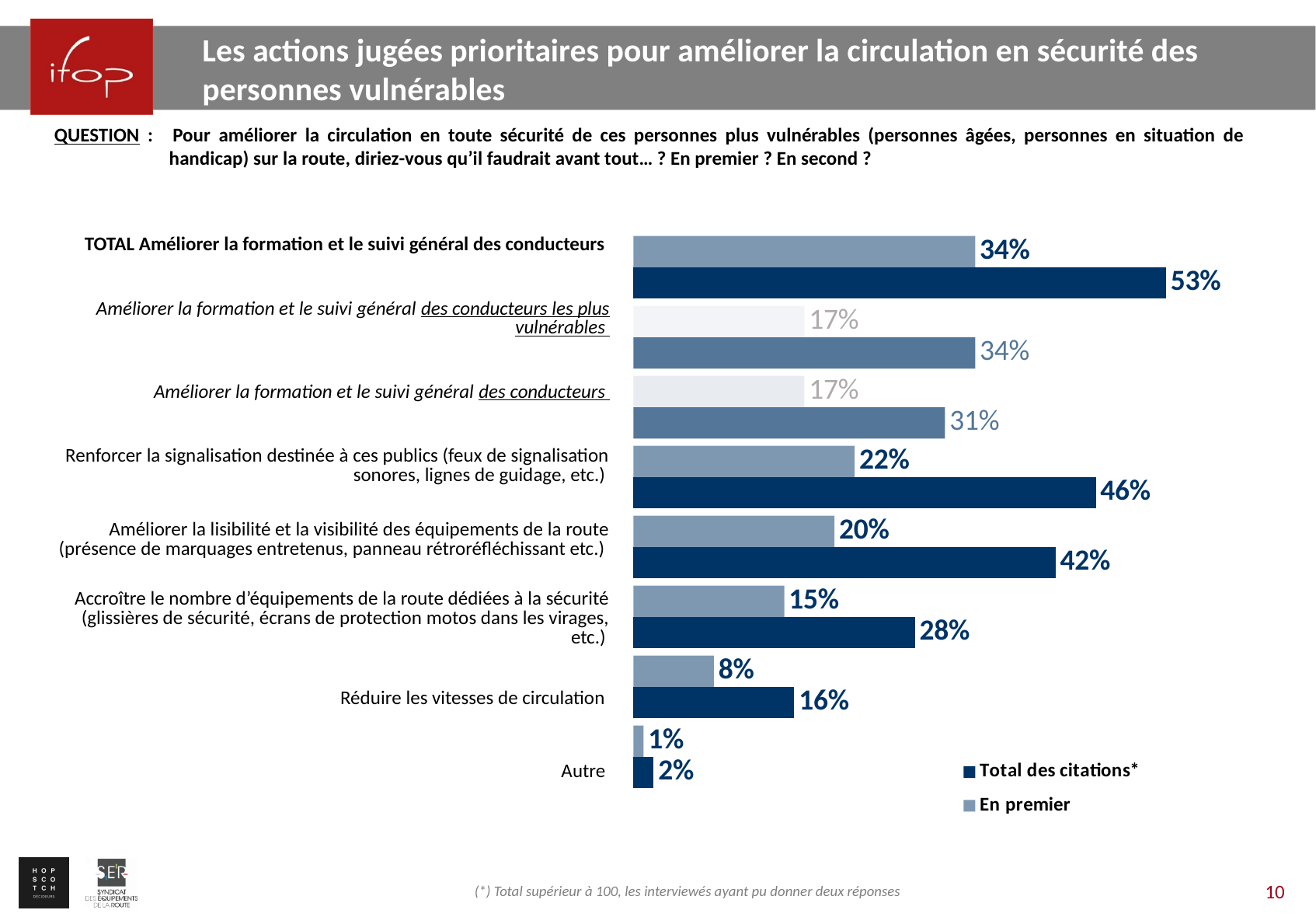
How many categories are shown on the chart? 8 Which category has the lowest 'En premier' value? Autre What is the 'En premier' value for 'TOTAL Améliorer la formation et le suivi général des conducteurs'? 34% Which is larger: the 'Total des citations' value for 'Renforcer la signalisation destinée à ces publics' or for 'Améliorer la lisibilité et la visibilité des équipements de la route'? Renforcer la signalisation destinée à ces publics How many series does the legend list? 2 What are the two legend entries of the chart? Total des citations* and En premier What is the difference between the 'Total des citations' and 'En premier' values for 'Accroître le nombre d'équipements de la route dédiées à la sécurité'? 13% What is the 'Total des citations' value for 'Renforcer la signalisation destinée à ces publics'? 46% What is the 'Total des citations' value for 'Réduire les vitesses de circulation'? 16% What kind of chart is shown on the slide? bar chart What is the 'En premier' value for 'Améliorer la lisibilité et la visibilité des équipements de la route'? 20% Which category has the highest 'Total des citations' value? TOTAL Améliorer la formation et le suivi général des conducteurs